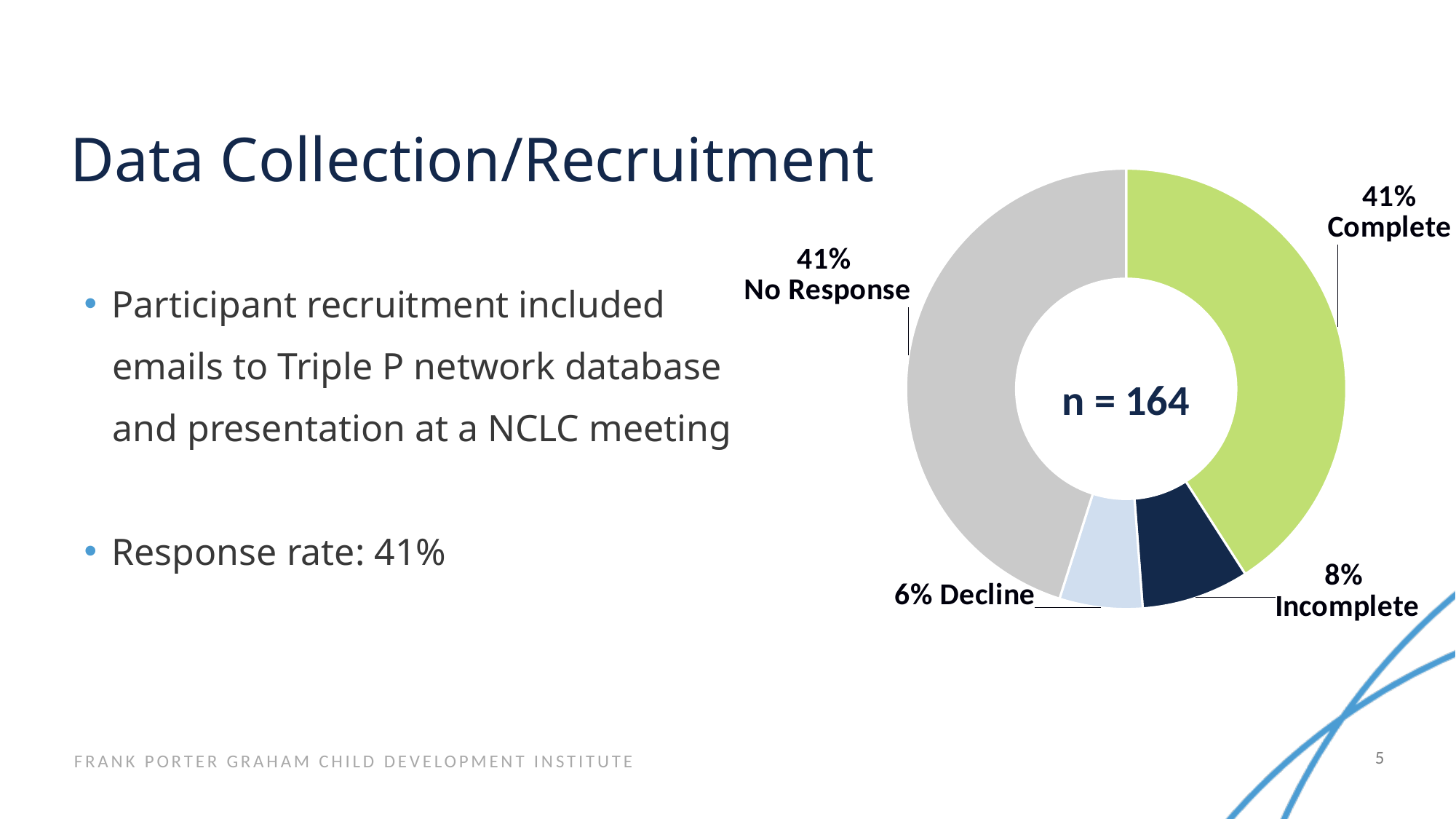
What share of the doughnut chart is labelled No Response? 41% What kind of chart is shown on the slide? Doughnut chart What share of the doughnut chart is labelled Decline? 6% Which is larger in the doughnut chart, Incomplete or Decline? Incomplete What colour is the Complete slice of the doughnut chart? Green What is the difference between the Complete and Incomplete shares in the doughnut chart? 33% What sample size is printed in the centre of the doughnut chart? n = 164 What share of the doughnut chart is labelled Complete? 41% How many slices does the doughnut chart have? 4 Which slice of the doughnut chart is the smallest? Decline What is the difference between the Incomplete and Decline shares in the doughnut chart? 2%